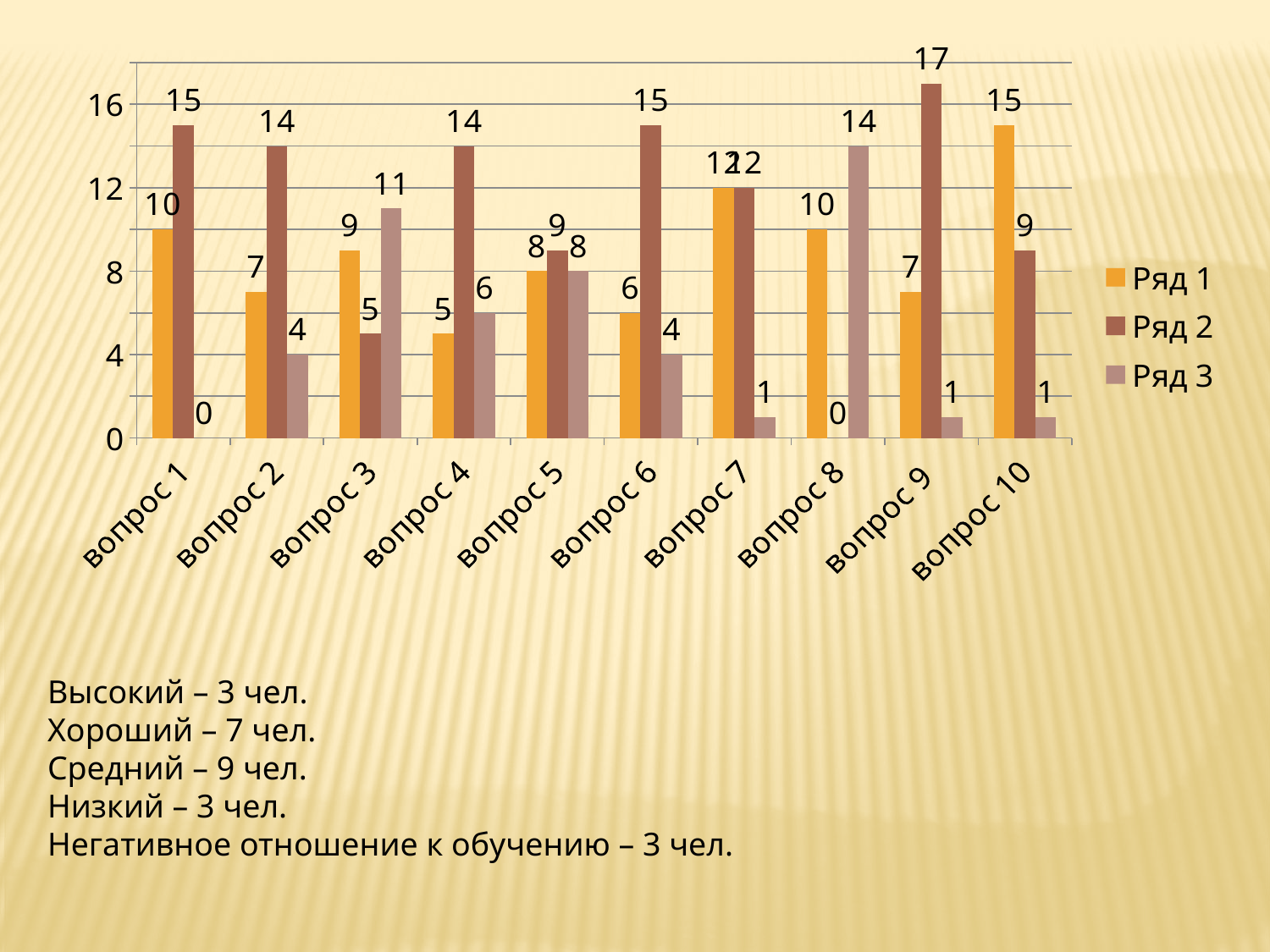
What is the difference between Ряд 2 and Ряд 1 for вопрос 6? 9 Which series is shown in orange? Ряд 1 Which is larger for вопрос 3: Ряд 1 or Ряд 3? Ряд 3 Which category has the lowest value for Ряд 1? вопрос 4 What is the value of Ряд 2 for вопрос 9? 17 What kind of chart is shown on the slide? bar chart How many categories are shown on the x axis? 10 What is the value of Ряд 3 for вопрос 8? 14 How many series does the legend list? 3 What is the value of Ряд 3 for вопрос 3? 11 What is the value of Ряд 1 for вопрос 10? 15 Which category has the highest value for Ряд 2? вопрос 9